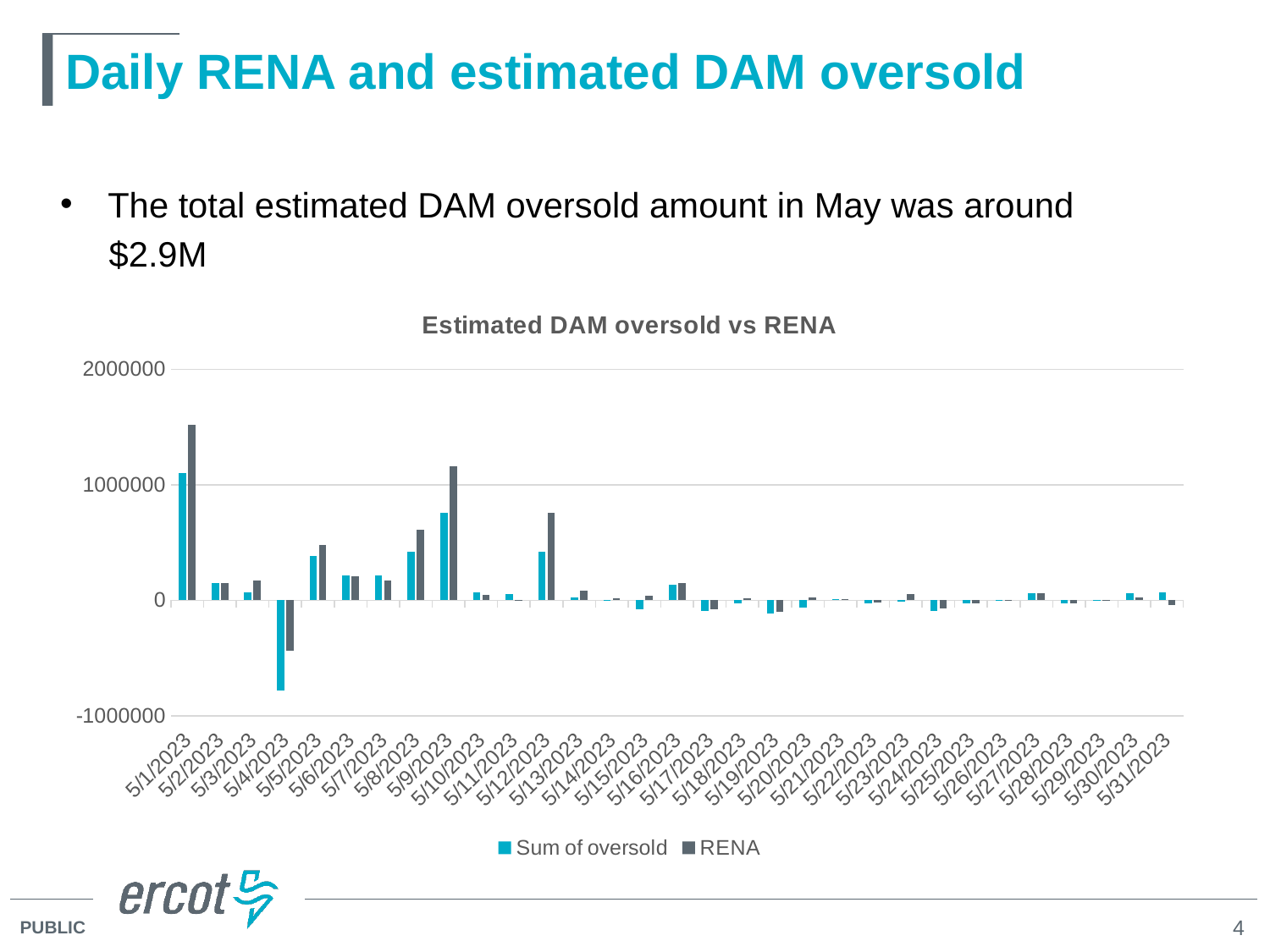
How many series does the chart's legend list? 2 Is the RENA value for 5/1/2023 greater or less than 1000000? greater On 5/12/2023, which is larger: Sum of oversold or RENA? RENA On which date is the RENA value highest? 5/1/2023 On which date is the Sum of oversold value lowest? 5/4/2023 Is the Sum of oversold value for 5/4/2023 greater or less than 0? less What is the title of the chart? Estimated DAM oversold vs RENA What are the two series named in the legend? Sum of oversold and RENA On 5/1/2023, which is larger: Sum of oversold or RENA? RENA What kind of chart is shown on the slide? Bar chart How many dates are shown along the x axis of the chart? 31 On which date is the Sum of oversold value highest? 5/1/2023